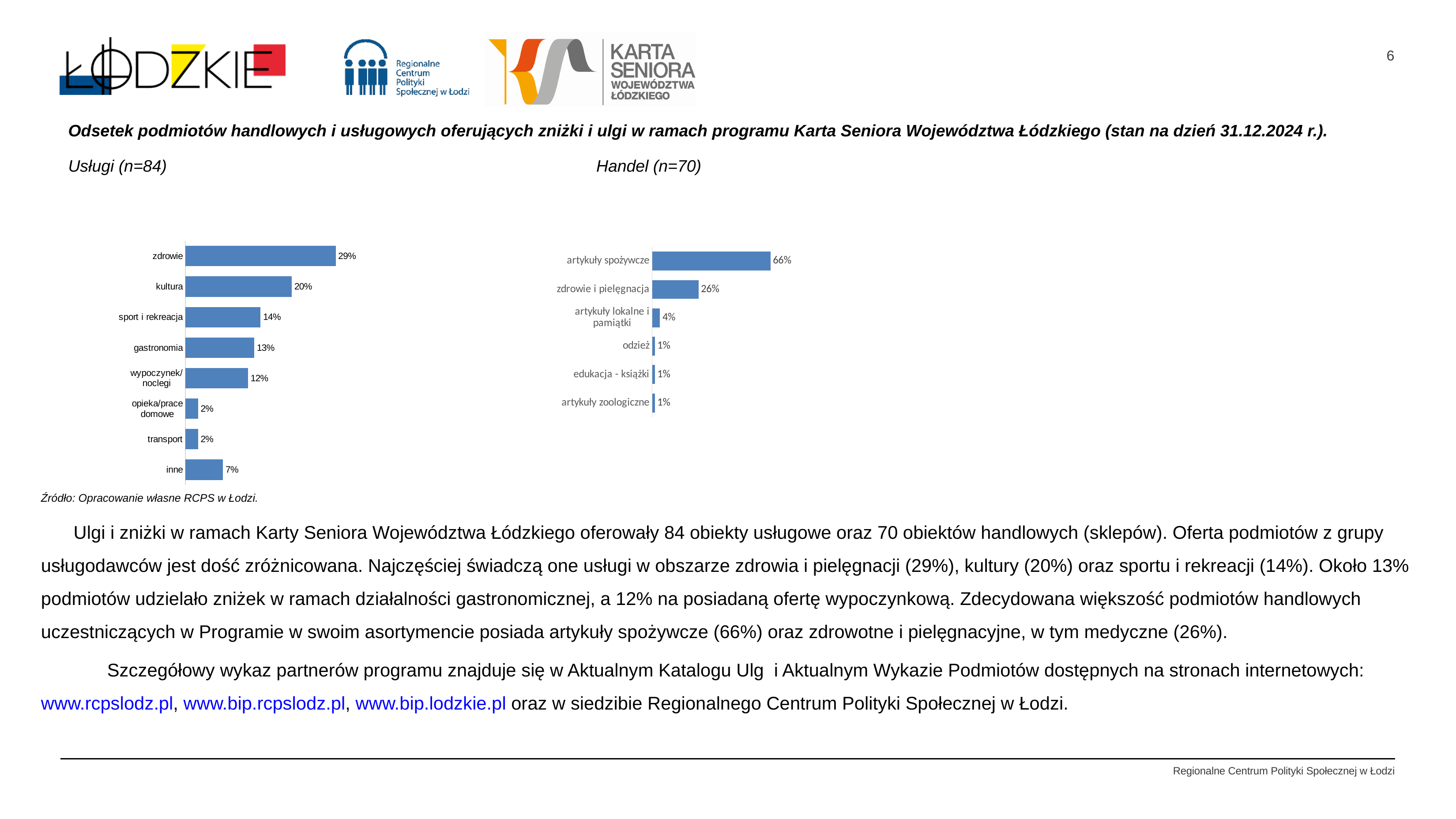
In the Usługi (n=84) chart, which category has the highest value? zdrowie In the Usługi (n=84) chart, what is the value for gastronomia? 13% In the Handel (n=70) chart, what is the value for artykuły lokalne i pamiątki? 4% In the Handel (n=70) chart, what is the value for artykuły spożywcze? 66% In the Usługi (n=84) chart, which is larger: wypoczynek/noclegi or inne? wypoczynek/noclegi In the Usługi (n=84) chart, what is the difference between kultura and sport i rekreacja? 6% In the Handel (n=70) chart, what is the difference between artykuły spożywcze and zdrowie i pielęgnacja? 40% How many categories are shown in the Handel (n=70) chart? 6 How many categories are shown in the Usługi (n=84) chart? 8 In the Usługi (n=84) chart, what is the value for zdrowie? 29% What type of chart is the Handel (n=70) chart? bar chart